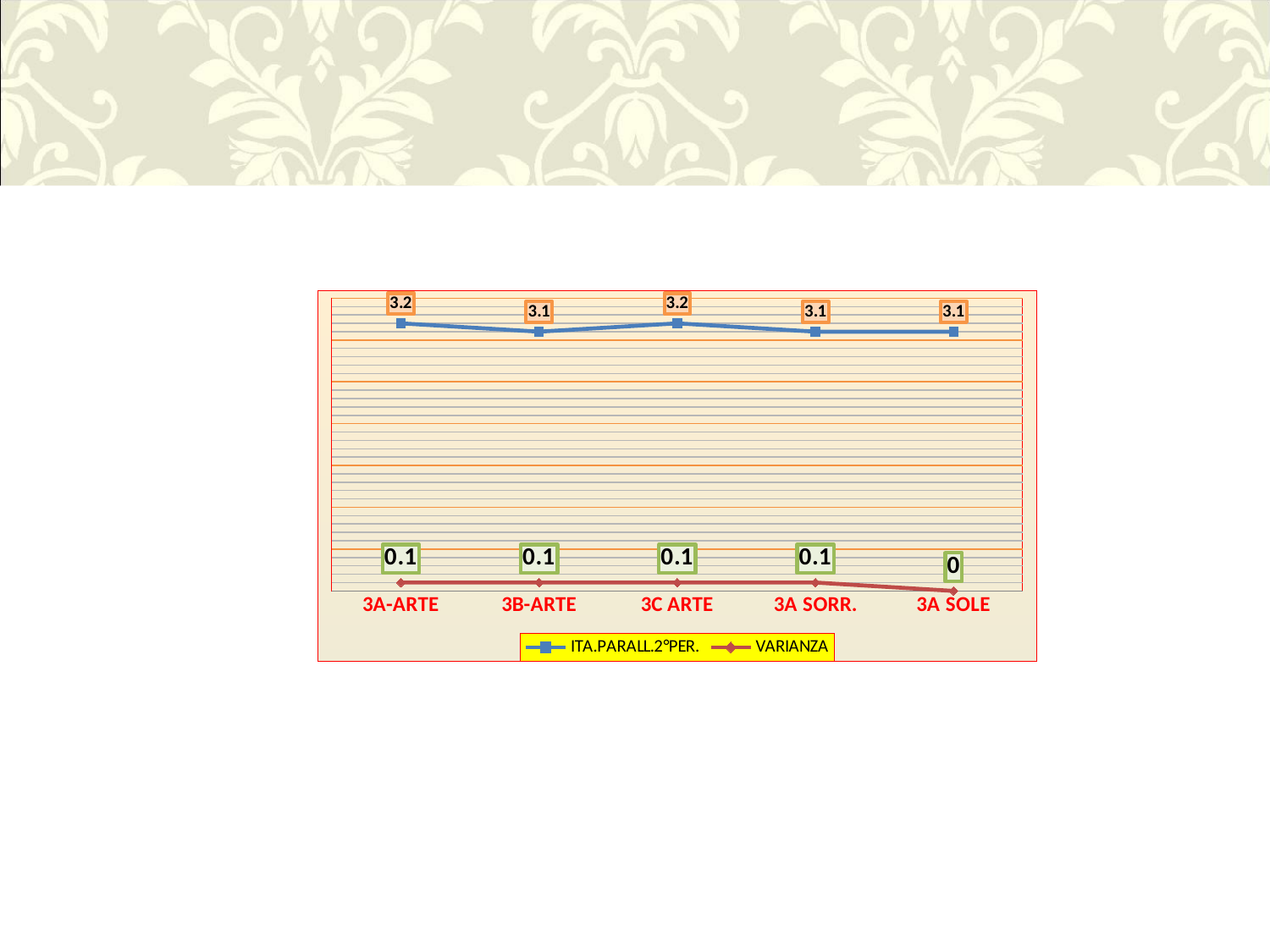
Which category has the lowest VARIANZA value? 3A SOLE Which is larger, the ITA.PARALL.2°PER. value for 3C ARTE or for 3A SOLE? 3C ARTE What is the VARIANZA value for 3C ARTE? 0.1 Which series is drawn in blue? ITA.PARALL.2°PER. What is the ITA.PARALL.2°PER. value for 3A-ARTE? 3.2 How many categories are shown on the x axis? 5 What is the difference between the ITA.PARALL.2°PER. values for 3A-ARTE and 3B-ARTE? 0.1 What is the ITA.PARALL.2°PER. value for 3A SORR.? 3.1 What is the VARIANZA value for 3A SOLE? 0 How many series does the legend list? 2 What is the ITA.PARALL.2°PER. value for 3B-ARTE? 3.1 What kind of chart is shown on the slide? Line chart